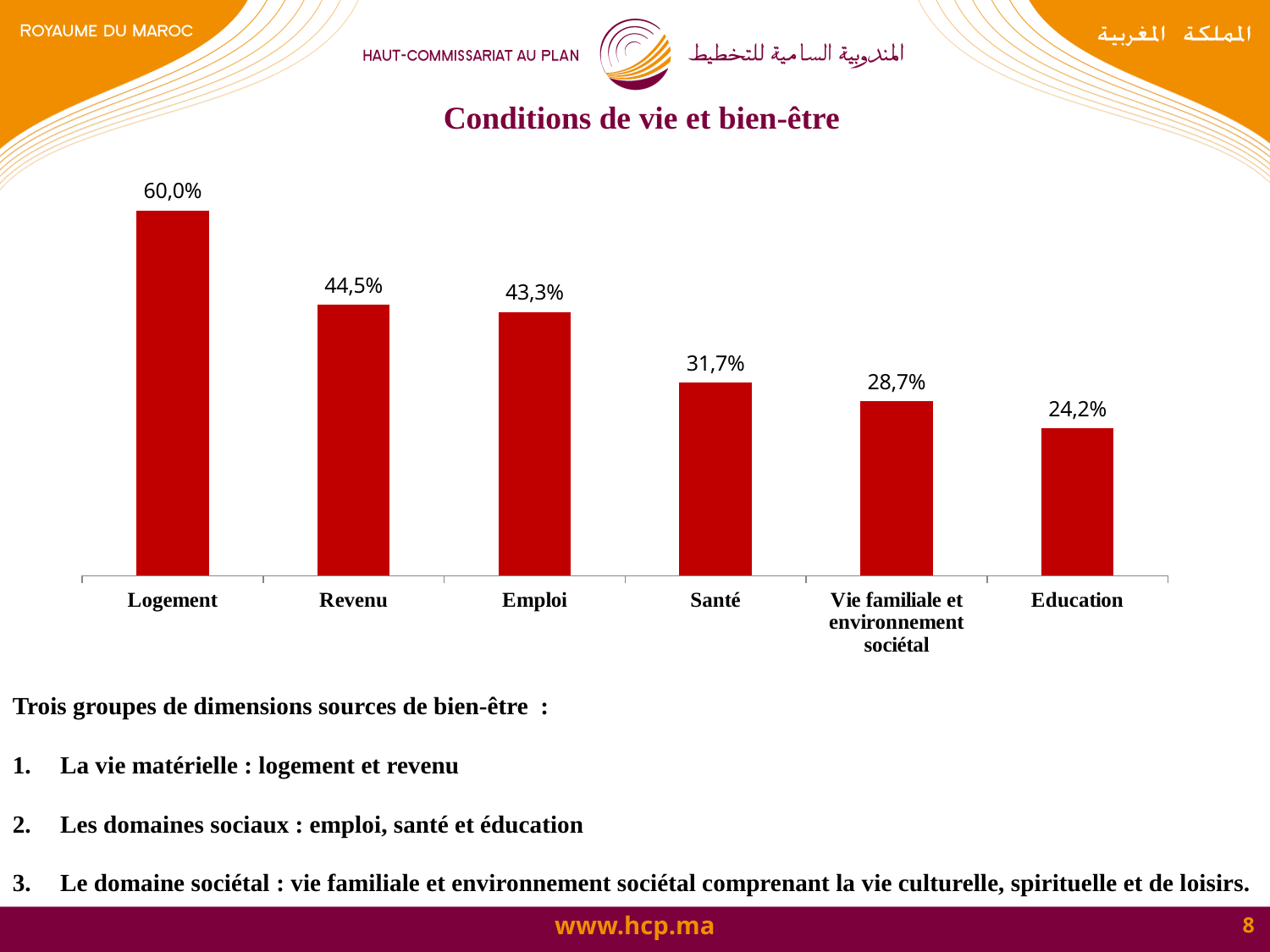
Which is larger, the value for Revenu or the value for Emploi? Revenu Do the values rise or fall from left to right along the x axis? Fall What is the value for Education? 24,2% What is the value for Vie familiale et environnement sociétal? 28,7% What is the difference between the values for Logement and Revenu? 15,5% What is the value for Logement? 60,0% What is the value for Santé? 31,7% What kind of chart is shown on the slide? Bar chart Which category has the lowest value? Education What is the difference between the values for Santé and Education? 7,5% How many categories are shown in the chart? 6 Which category has the highest value? Logement